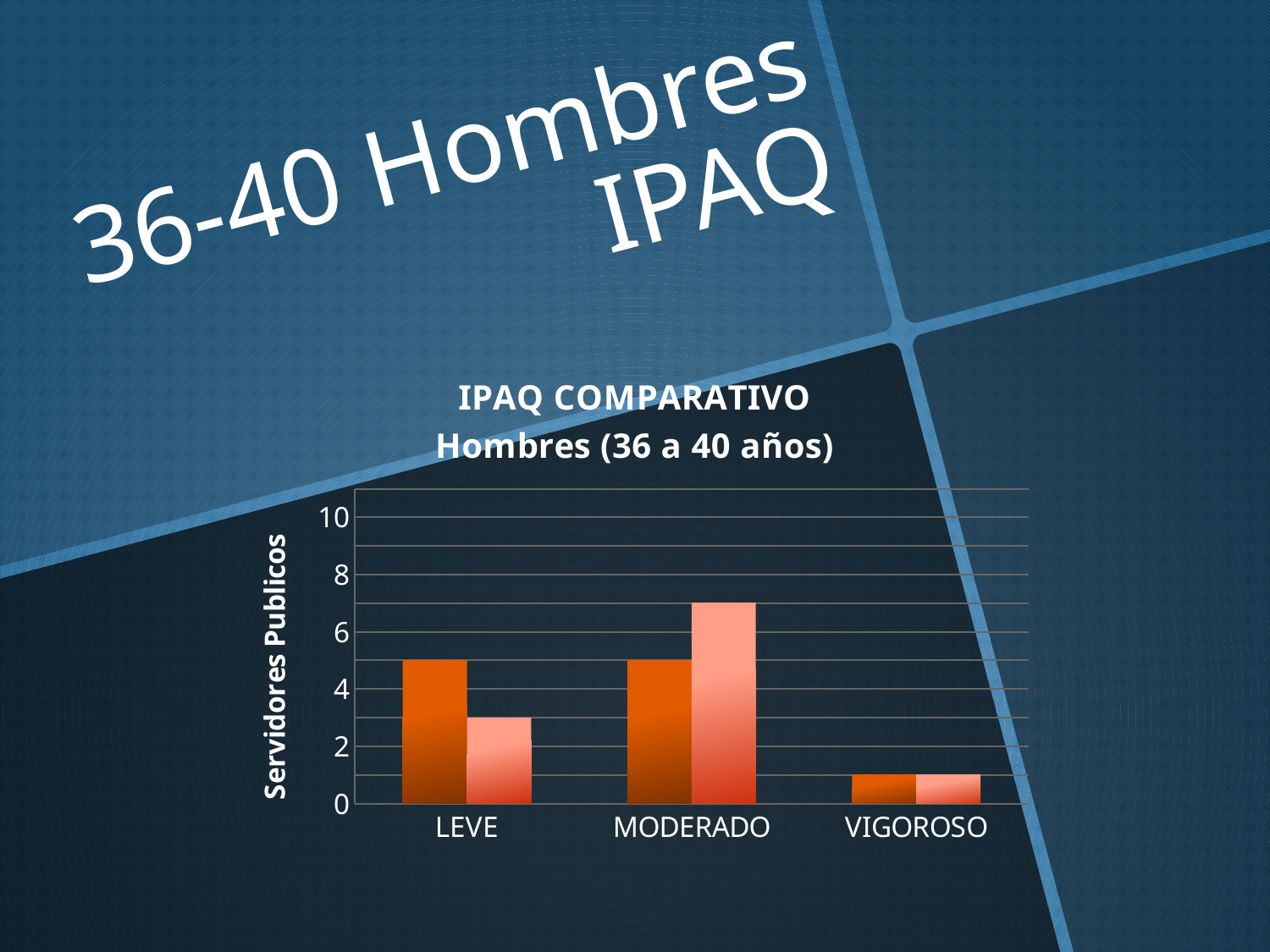
How many categories are shown on the x axis of the chart? 3 Which category has the lowest bars in the chart? VIGOROSO What is the label on the vertical axis of the chart? Servidores Publicos For MODERADO, which bar is taller, the dark orange bar or the light pink bar? light pink bar What is the title of the chart? IPAQ COMPARATIVO Hombres (36 a 40 años) Is the value of the dark orange bar for VIGOROSO greater or less than 2? less Is the value of the light pink bar for MODERADO greater or less than 6? greater What kind of chart is shown on the slide? bar chart Is the value of the light pink bar for LEVE greater or less than 4? less For LEVE, which bar is taller, the dark orange bar or the light pink bar? dark orange bar Which category contains the tallest bar in the chart? MODERADO